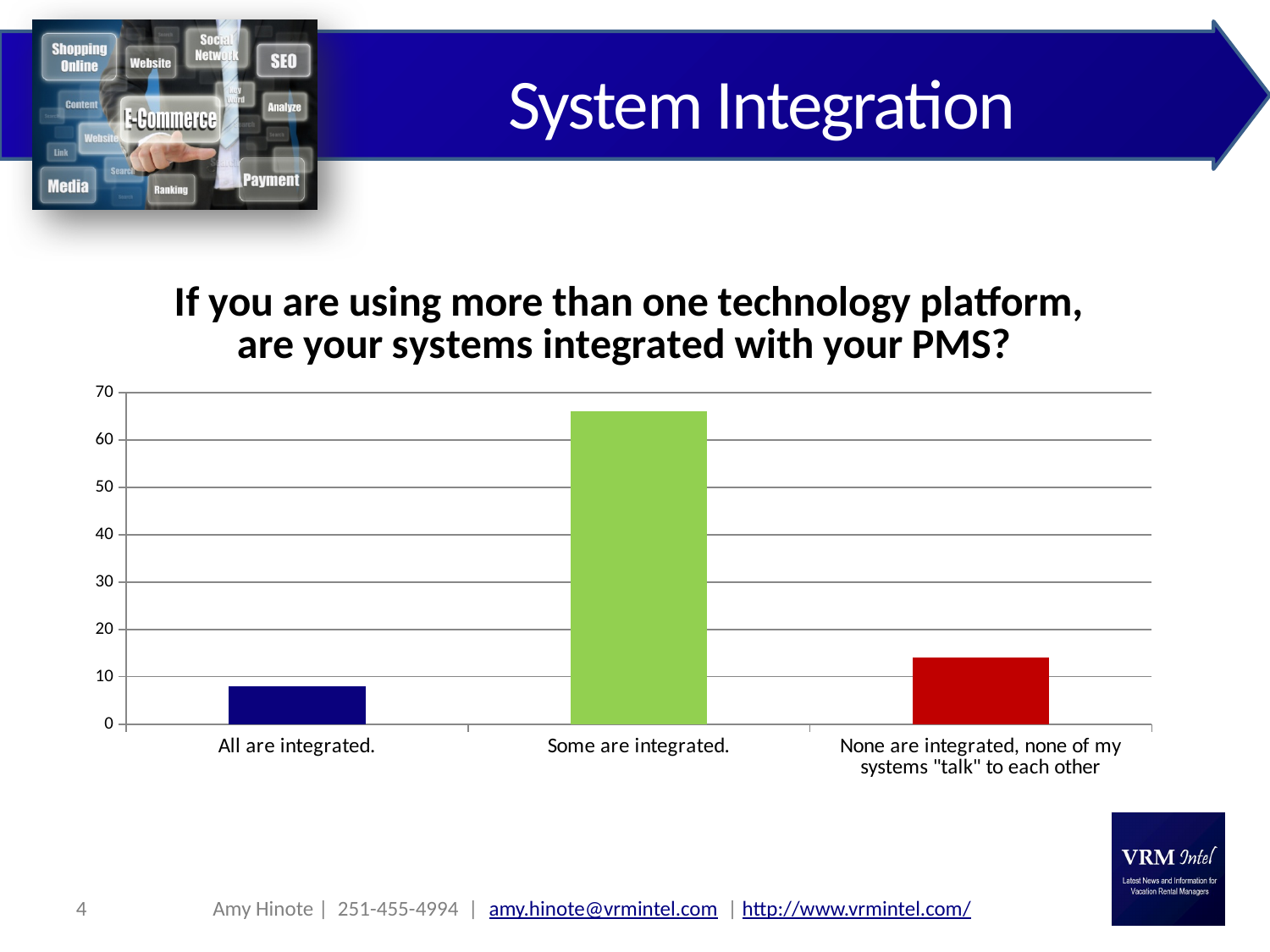
Which is larger: the value for "All are integrated." or the value for "None are integrated, none of my systems "talk" to each other"? None are integrated, none of my systems "talk" to each other What is the highest value shown on the chart's vertical axis? 70 What colour is the bar for "Some are integrated."? green What kind of chart is shown on the slide? bar chart How many categories are shown on the x axis of the chart? 3 Which category has the highest value in the chart? Some are integrated. Which category has the lowest value in the chart? All are integrated. Is the value for "None are integrated, none of my systems "talk" to each other" greater or less than 20? less Is the value for "All are integrated." greater or less than 10? less Is the value for "Some are integrated." greater or less than 60? greater Which is larger: the value for "Some are integrated." or the value for "All are integrated."? Some are integrated.